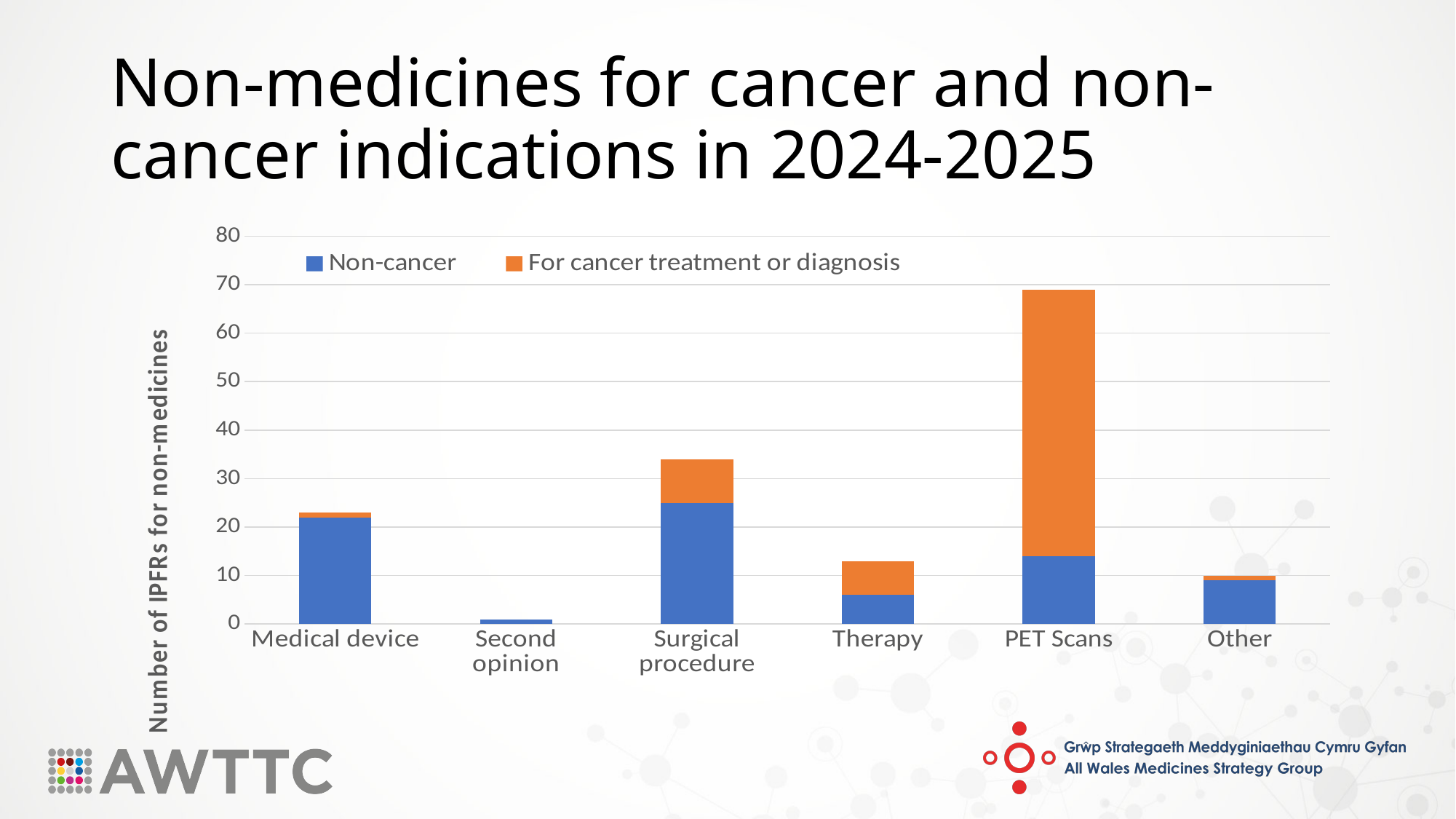
How many categories are shown on the x axis of the chart? 6 How many series does the chart's legend list? 2 Is the total value for PET Scans greater or less than 60? greater Which category has the larger Non-cancer segment, Surgical procedure or PET Scans? Surgical procedure What kind of chart is shown on the slide? Stacked bar chart Which has the larger total bar, Surgical procedure or Medical device? Surgical procedure Which category has the shortest stacked bar overall? Second opinion Is the total value for Therapy greater or less than 20? less Is the total value for Surgical procedure greater or less than 30? greater What is the title of the chart's vertical axis? Number of IPFRs for non-medicines Which category has the tallest stacked bar overall? PET Scans